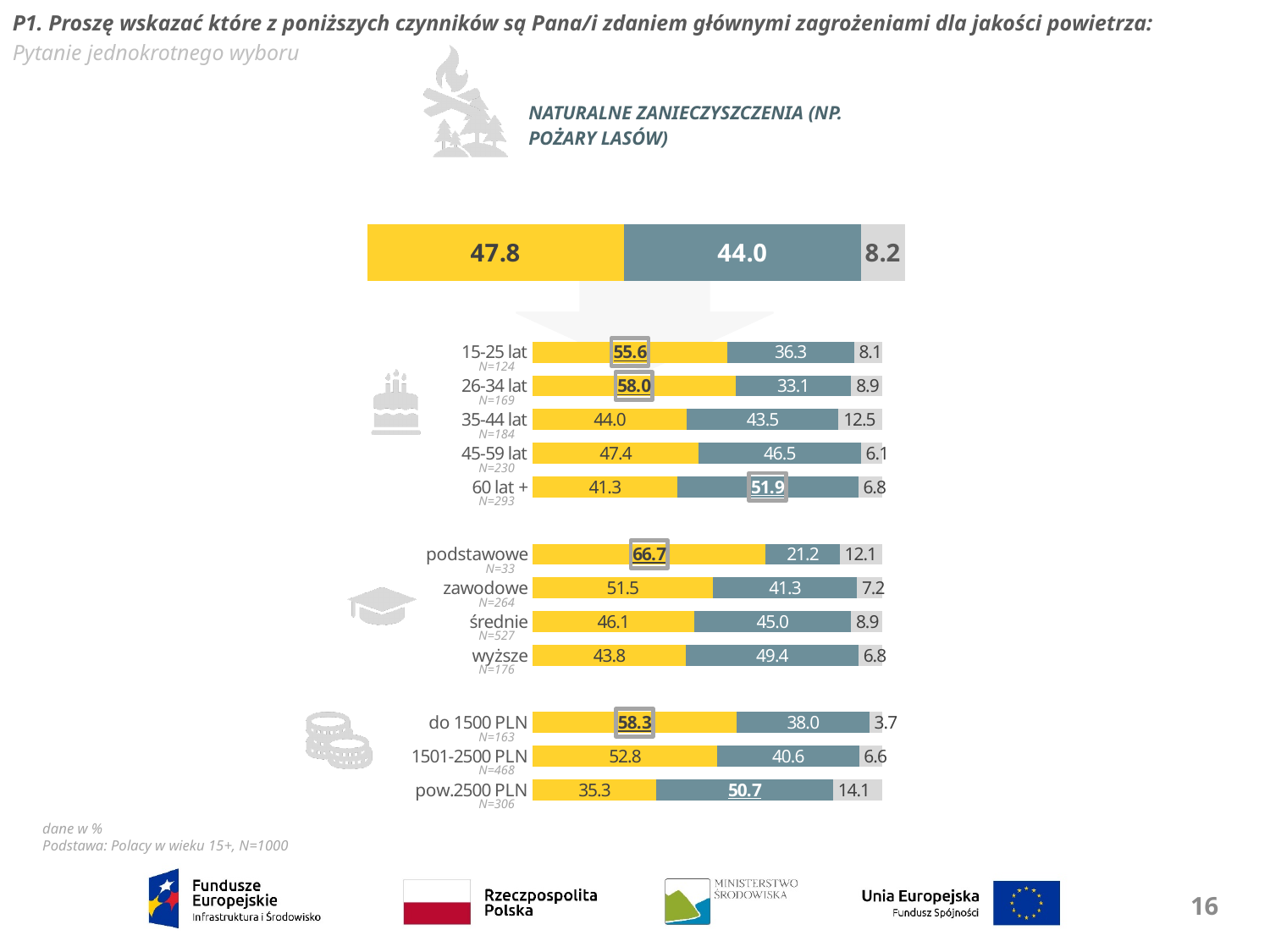
Which has a larger yellow segment value: podstawowe or wyższe? podstawowe What kind of chart is shown on the slide? Stacked bar chart Among the income groups, which has the lowest yellow segment value? pow.2500 PLN What is the value of the light grey segment for the pow.2500 PLN income group? 14.1 What is the value of the light grey segment in the overall (top) bar? 8.2 What is the total of the three segments in the 15-25 lat bar? 100.0 In the overall (top) bar, what is the difference between the yellow value and the grey-blue value? 3.8 Among the age groups, which has the highest yellow segment value? 26-34 lat What is the value of the grey-blue segment for the 60 lat + age group? 51.9 How many education level categories are shown in the chart? 4 How many age group categories are shown in the chart? 5 What is the value of the yellow segment for the 26-34 lat age group? 58.0